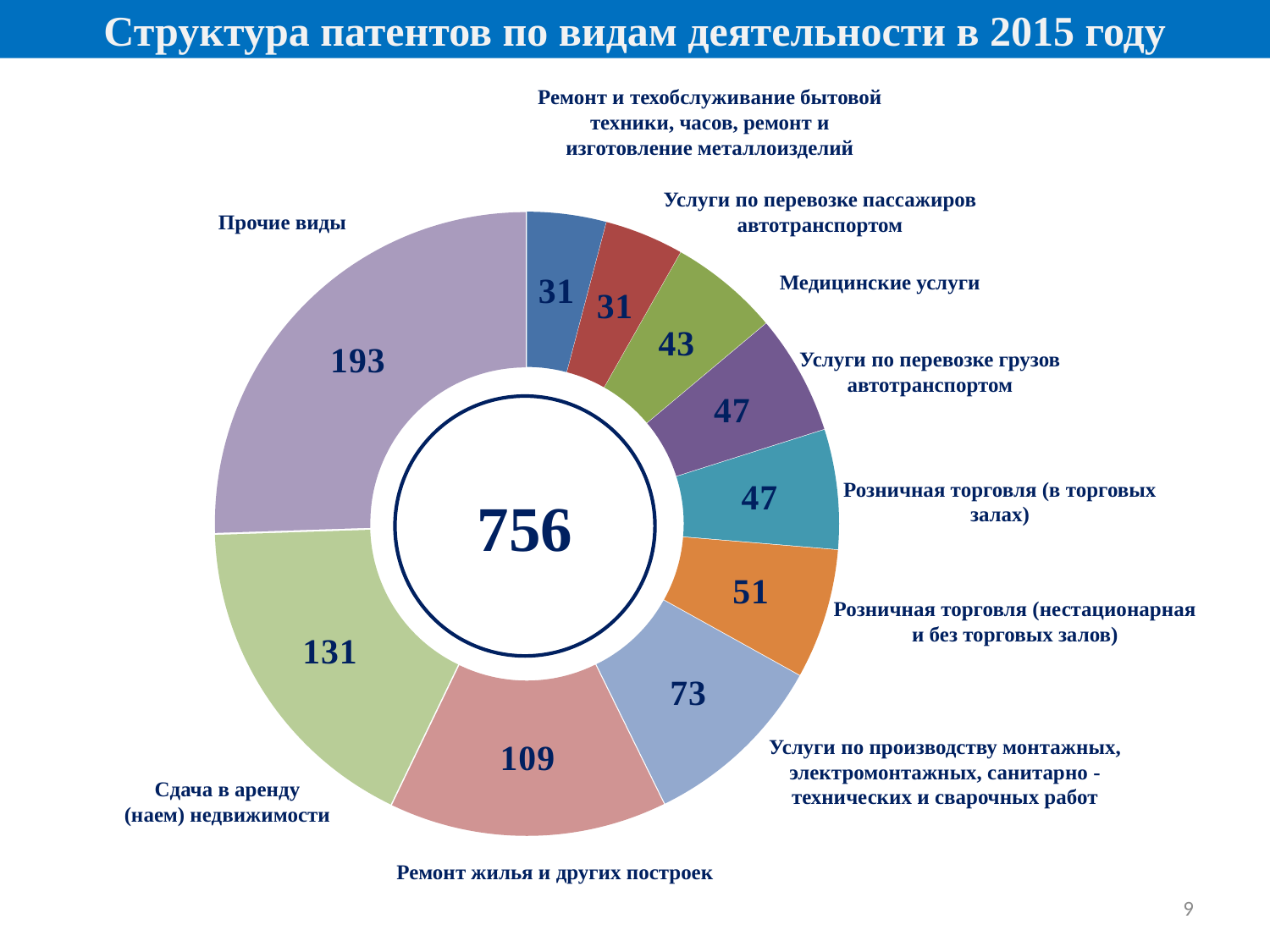
Which is larger: Ремонт жилья и других построек or Услуги по производству монтажных, электромонтажных, санитарно-технических и сварочных работ? Ремонт жилья и других построек What is the value for Прочие виды? 193 What is the smallest value shown on the chart? 31 Which category has the largest value? Прочие виды What is the value for Розничная торговля (нестационарная и без торговых залов)? 51 What is the difference between Прочие виды and Сдача в аренду (наем) недвижимости? 62 What is the value for Ремонт жилья и других построек? 109 What is the total number shown in the centre of the chart? 756 What is the value for Медицинские услуги? 43 How many categories does the chart show? 10 What is the value for Сдача в аренду (наем) недвижимости? 131 What type of chart is shown on the slide? Doughnut (pie) chart